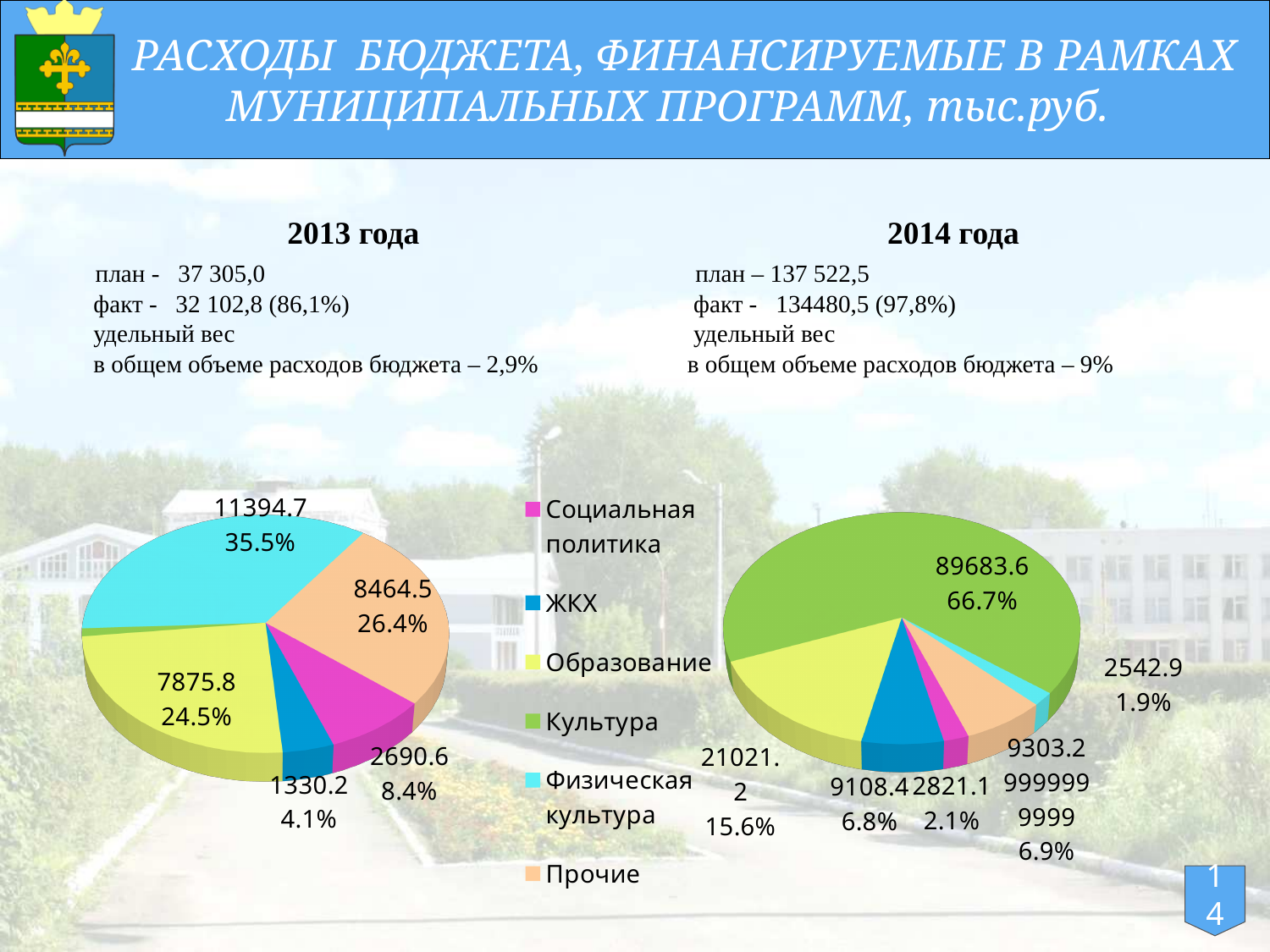
In the right pie chart (2014), what share of the pie does Физическая культура take? 1.9% In the right pie chart (2014), what is the value for Культура? 89683.6 In the left pie chart (2013), what share of the pie does Образование take? 24.5% In the left pie chart (2013), what is the difference between the values for Физическая культура and Прочие? 2930.2 In the left pie chart (2013), which category has the smallest slice? Культура In the left pie chart (2013), which category has the largest slice? Физическая культура In the right pie chart (2014), which is larger, the value for ЖКХ or the value for Социальная политика? ЖКХ How many slices does the left pie chart (2013) have? 6 In the left pie chart (2013), what is the value for Физическая культура? 11394.7 In the right pie chart (2014), what is the difference between the values for Культура and Образование? 68662.4 How many entries does the legend between the two pie charts list? 6 What kind of charts are shown on the slide? Pie charts